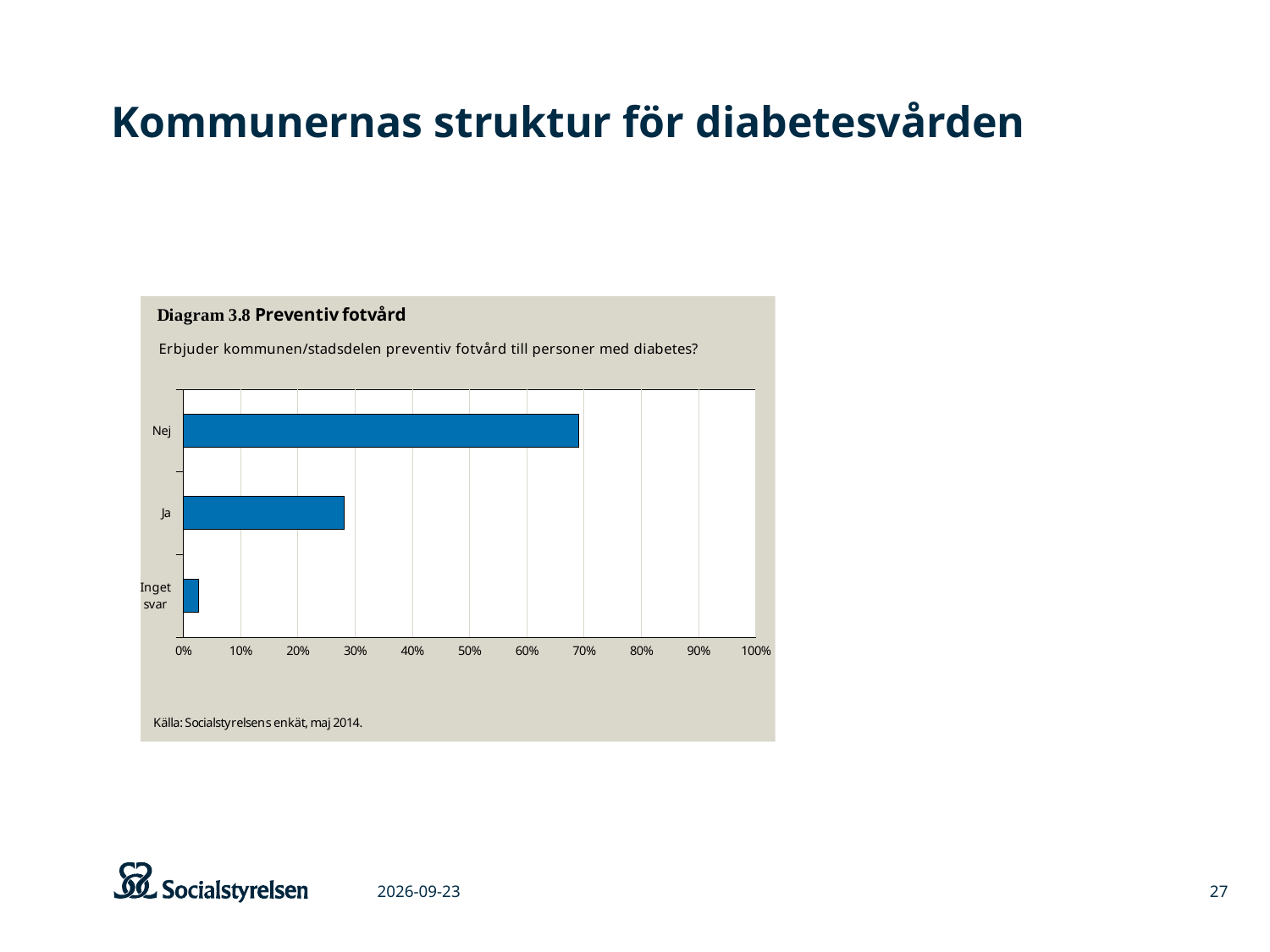
Is the value for Ja greater or less than 40%? less Which is larger, the value for Ja or the value for Inget svar? Ja Is the value for Nej greater or less than 60%? greater Which is larger, the value for Nej or the value for Ja? Nej How many response categories are shown in the chart? 3 Is the value for Ja greater or less than 20%? greater What kind of chart is shown in Diagram 3.8? bar chart Which response category has the longest bar? Nej What is the maximum value shown on the x axis of the chart? 100% What is the title of the diagram shown on the slide? Diagram 3.8 Preventiv fotvård Which response category has the shortest bar? Inget svar